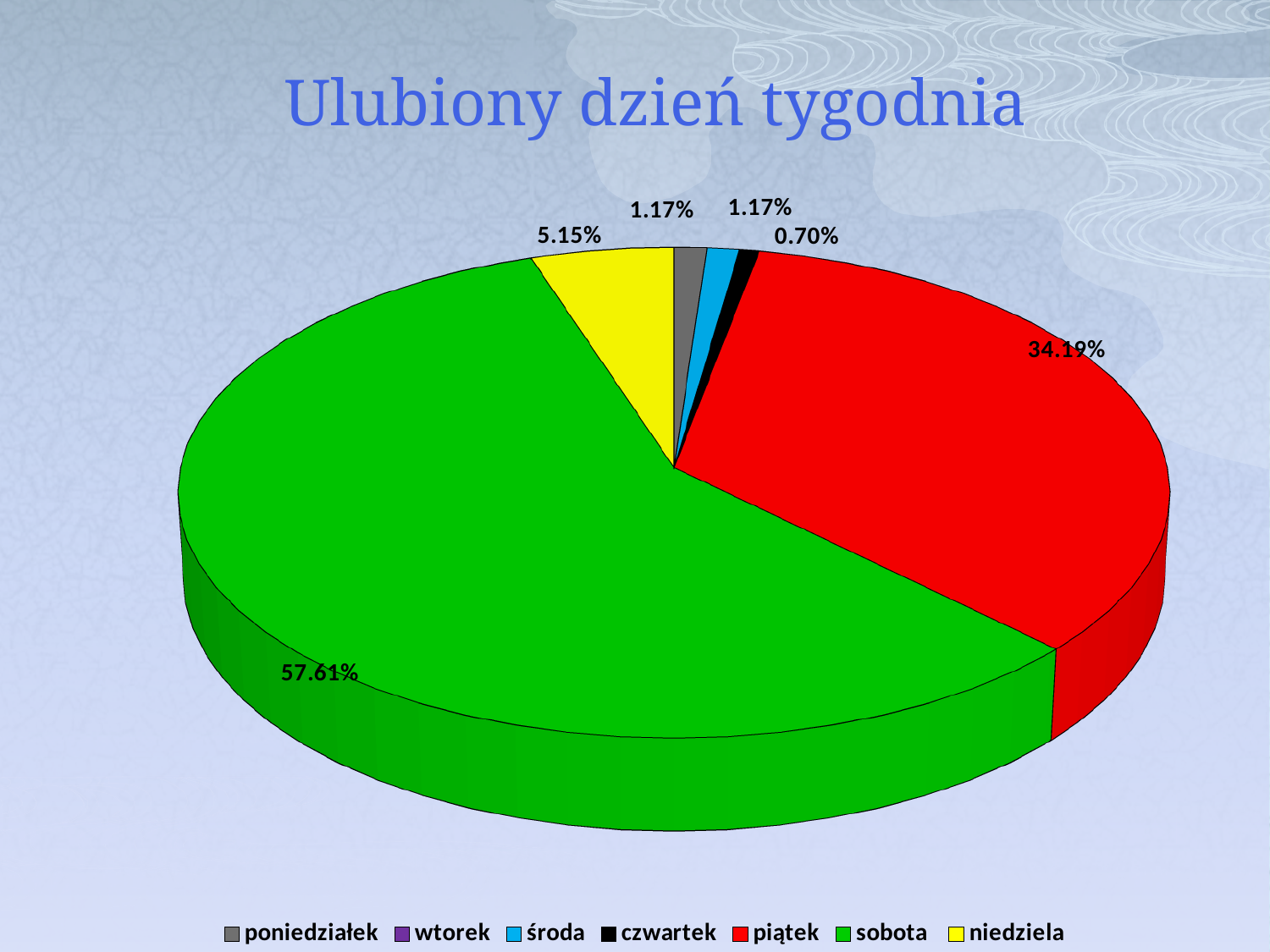
What percentage is shown for środa? 1.17% What is the value shown for czwartek? 0.70% What kind of chart is shown on the slide? pie chart How many entries does the legend list? 7 What percentage is shown for niedziela? 5.15% Which day has the largest slice of the pie? sobota What percentage of the pie does sobota account for? 57.61% Which is larger, the slice for piątek or the slice for niedziela? piątek What is the title of the chart? Ulubiony dzień tygodnia What is the value shown for piątek? 34.19% What is the combined share of sobota and piątek? 91.80% By how many percentage points does sobota exceed piątek? 23.42 percentage points